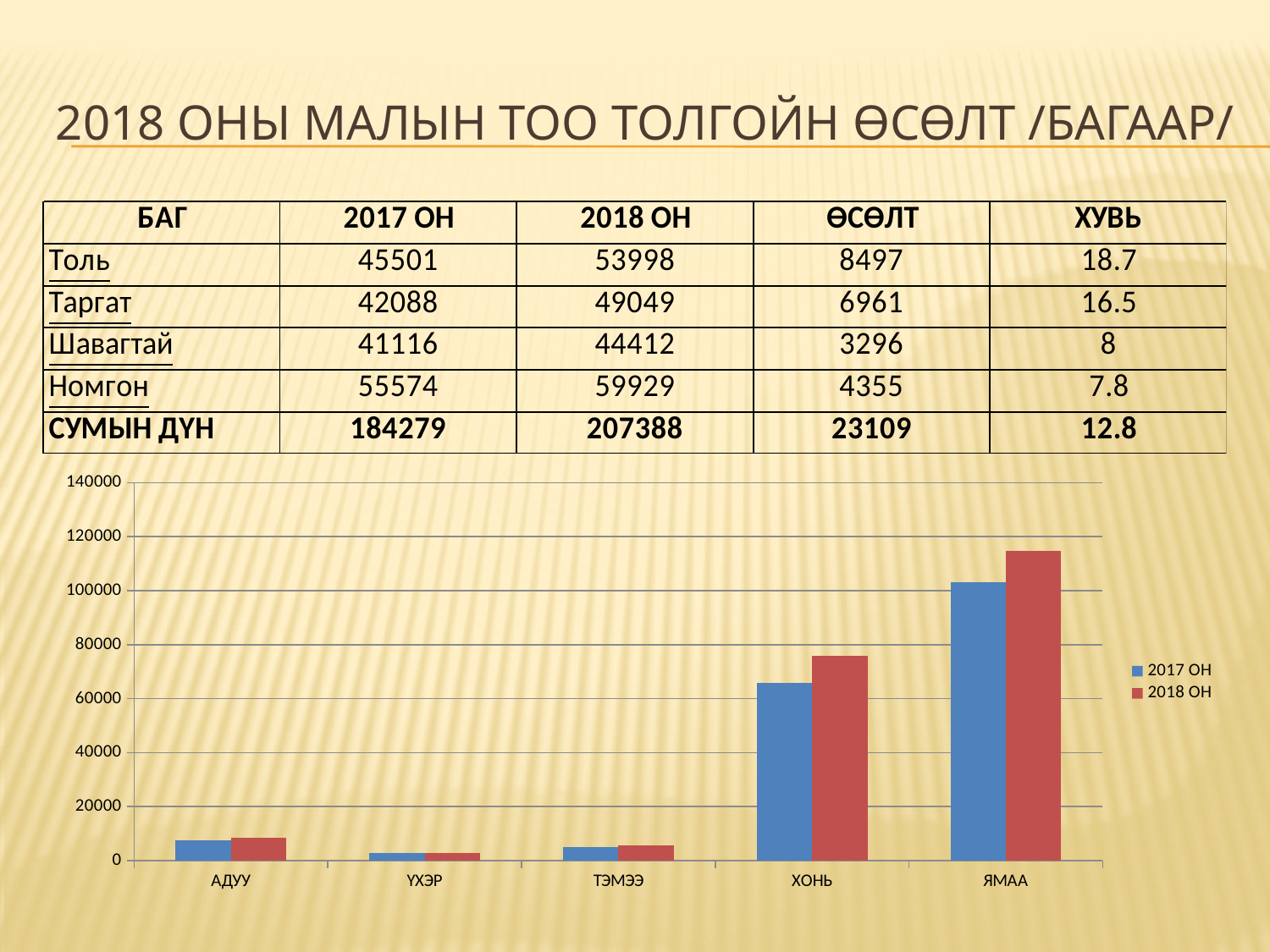
How many categories are shown on the x axis of the chart? 5 Which category has the highest bars in the chart? ЯМАА Is the 2018 ОН value for ЯМАА greater or less than 100000? greater For ХОНЬ, which series has the larger value, 2017 ОН or 2018 ОН? 2018 ОН Which colour represents the 2018 ОН series in the chart? red How many series does the chart legend list? 2 Which category has a larger 2018 ОН value, ХОНЬ or ЯМАА? ЯМАА Is the 2017 ОН value for ХОНЬ greater or less than 60000? greater Is the 2018 ОН value for ХОНЬ greater or less than 80000? less What kind of chart is shown on the slide? bar chart Which category has the lowest bars in the chart? ҮХЭР